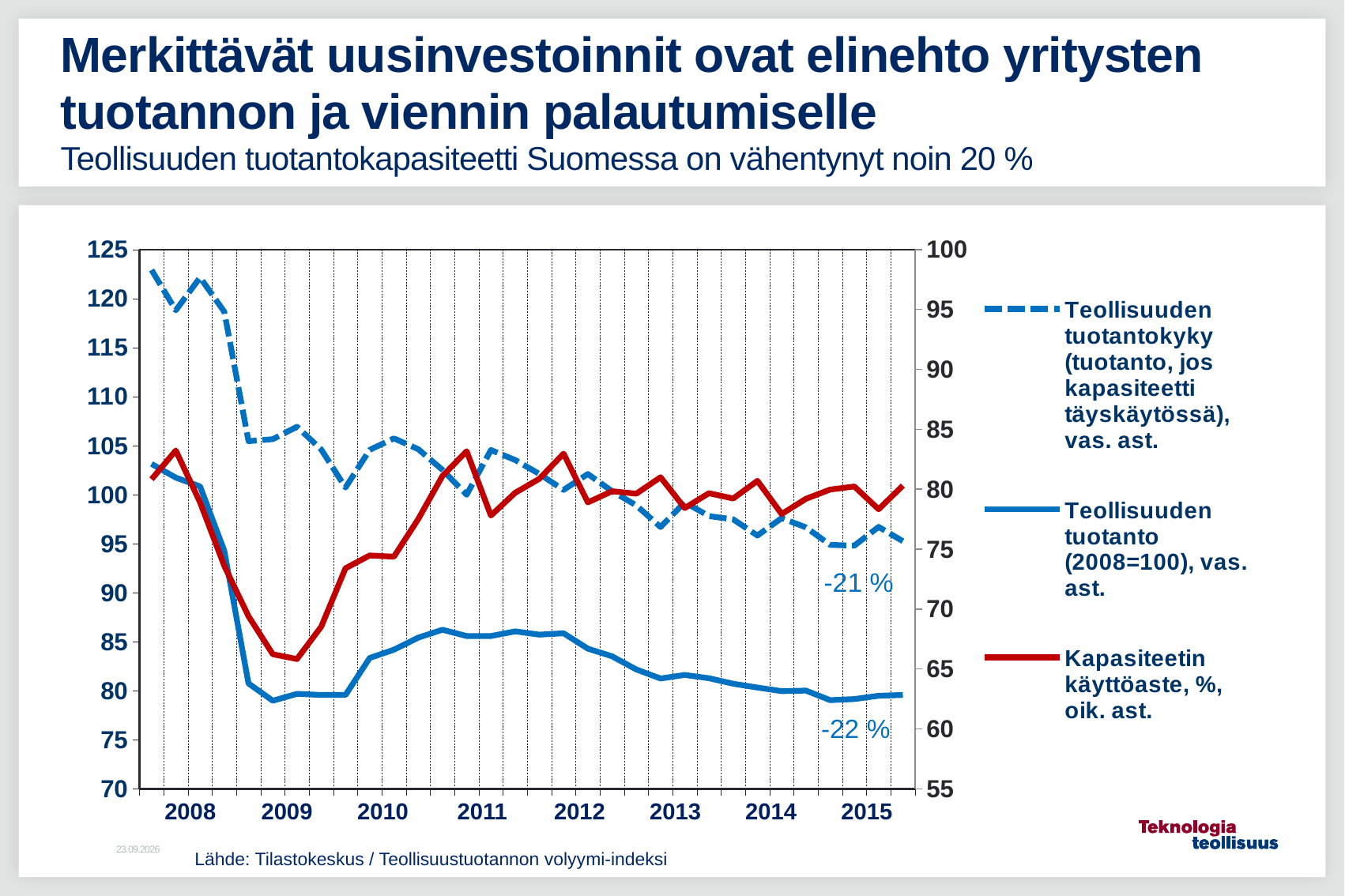
What percentage change is annotated next to the dashed Teollisuuden tuotantokyky line at the right end of the chart? -21 % What percentage change is annotated next to the solid Teollisuuden tuotanto line at the right end of the chart? -22 % How many series does the legend list? 3 Which series is plotted against the right-hand axis (oik. ast.)? Kapasiteetin käyttöaste, %, oik. ast. How many years are labelled on the x axis? 8 Is the Kapasiteetin käyttöaste (red) line at the start of 2009 greater or less than 70 on the right axis? less What kind of chart is shown on the slide? line chart Is the value of the Teollisuuden tuotanto (solid blue) line at the start of 2009 greater or less than 90 on the left axis? less Which series is drawn with a dashed line? Teollisuuden tuotantokyky (tuotanto, jos kapasiteetti täyskäytössä), vas. ast. Does the Teollisuuden tuotantokyky (dashed blue) line overall rise or fall from 2008 to 2015? fall Is the value of the Teollisuuden tuotantokyky (dashed blue) line at the start of 2008 greater or less than 115 on the left axis? greater Does the Teollisuuden tuotanto (solid blue) line overall rise or fall from 2008 to 2015? fall